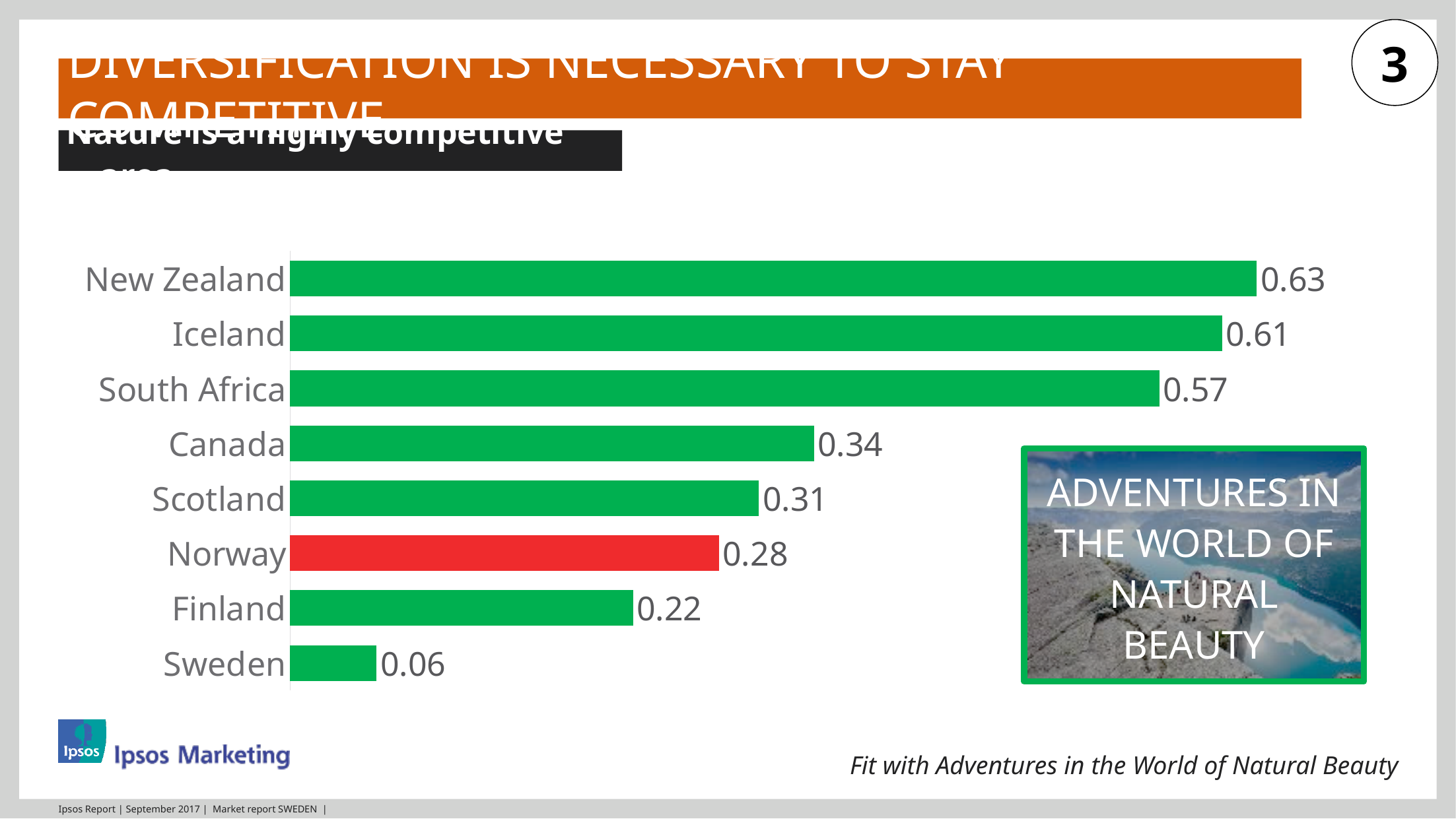
What is the value for Norway? 0.28 What is the value for New Zealand? 0.63 What is the difference between the values for Canada and Scotland? 0.03 What kind of chart is shown on the slide? Bar chart Which country has the lowest value? Sweden Which country's bar is coloured red rather than green? Norway What is the difference between the values for New Zealand and Sweden? 0.57 Which has a larger value, Finland or Norway? Norway How many countries are shown in the chart? 8 What is the value for South Africa? 0.57 What is the value for Sweden? 0.06 Which country has the highest value? New Zealand